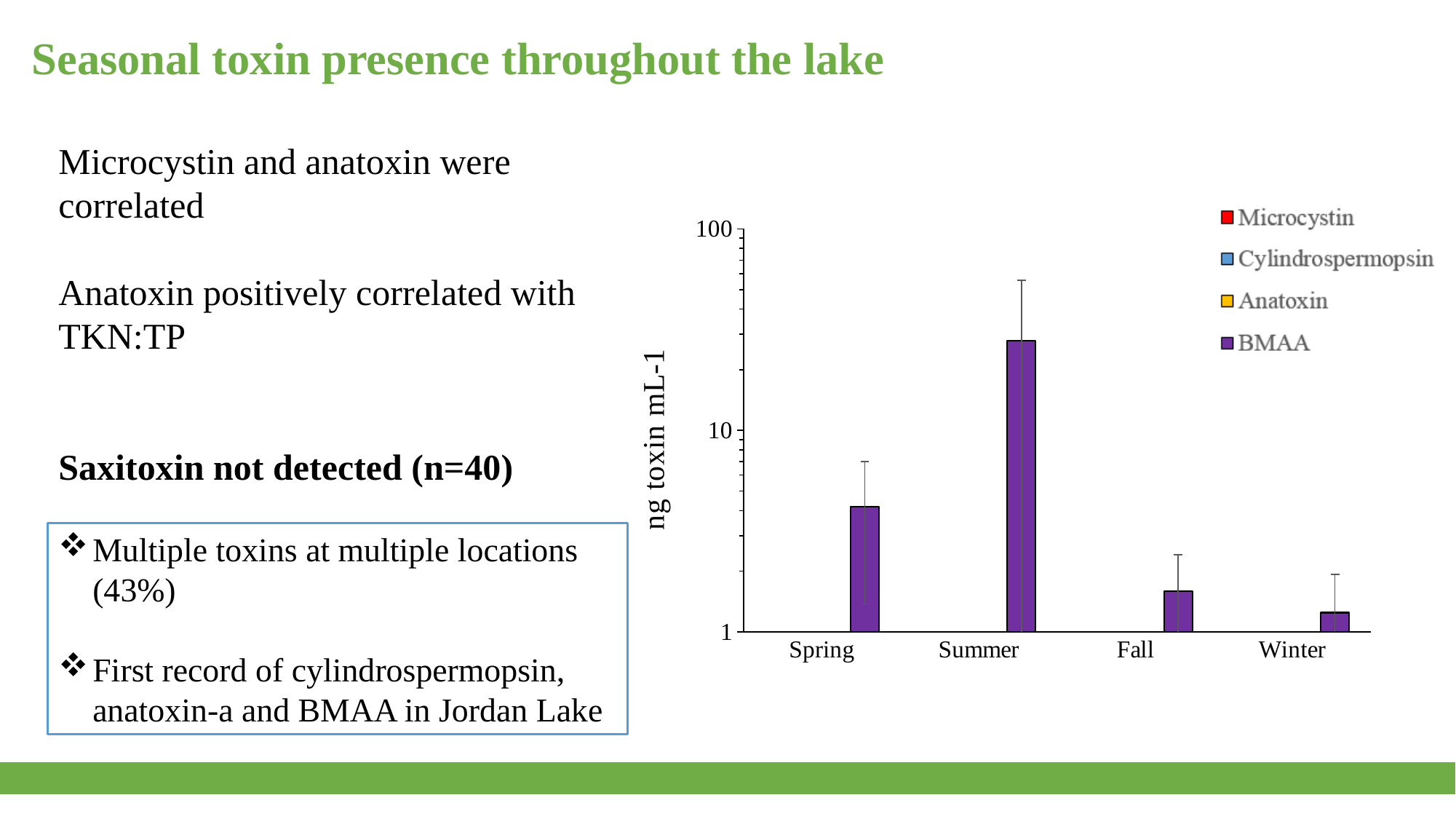
Is the BMAA value for Fall greater or less than 10? less Which season has the lowest BMAA value? Winter Which legend entry is shown in purple? BMAA Which season has a larger BMAA value, Spring or Fall? Spring What is the label on the y axis of the chart? ng toxin mL-1 How many series does the chart's legend list? 4 Is the BMAA value for Summer greater or less than 10? greater Is the BMAA value for Summer greater or less than 100? less What kind of chart is shown on the slide? bar chart How many seasons are shown on the x axis of the chart? 4 Which season has the highest BMAA value? Summer